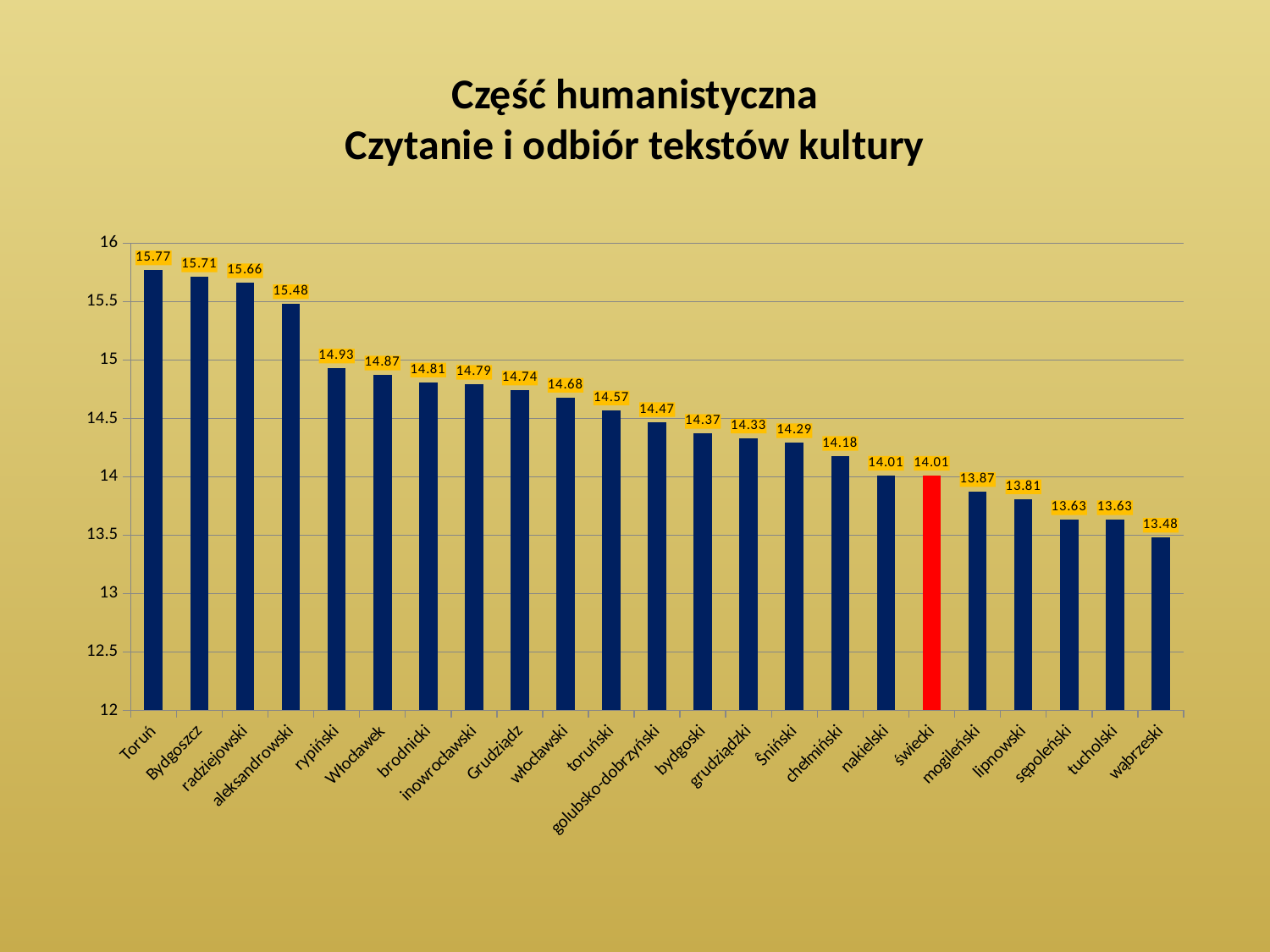
Which category's bar is coloured red? świecki How many categories are shown on the x axis? 23 What is the value for golubsko-dobrzyński? 14.47 What kind of chart is shown on the slide? bar chart Is the value for mogileński greater or less than 14? less What is the value for świecki? 14.01 What is the difference between the values for Toruń and wąbrzeski? 2.29 What is the difference between the values for Bydgoszcz and bydgoski? 1.34 Which category has the lowest value? wąbrzeski What is the value for Toruń? 15.77 Which category has the highest value? Toruń Which is larger, the value for rypiński or the value for Włocławek? rypiński